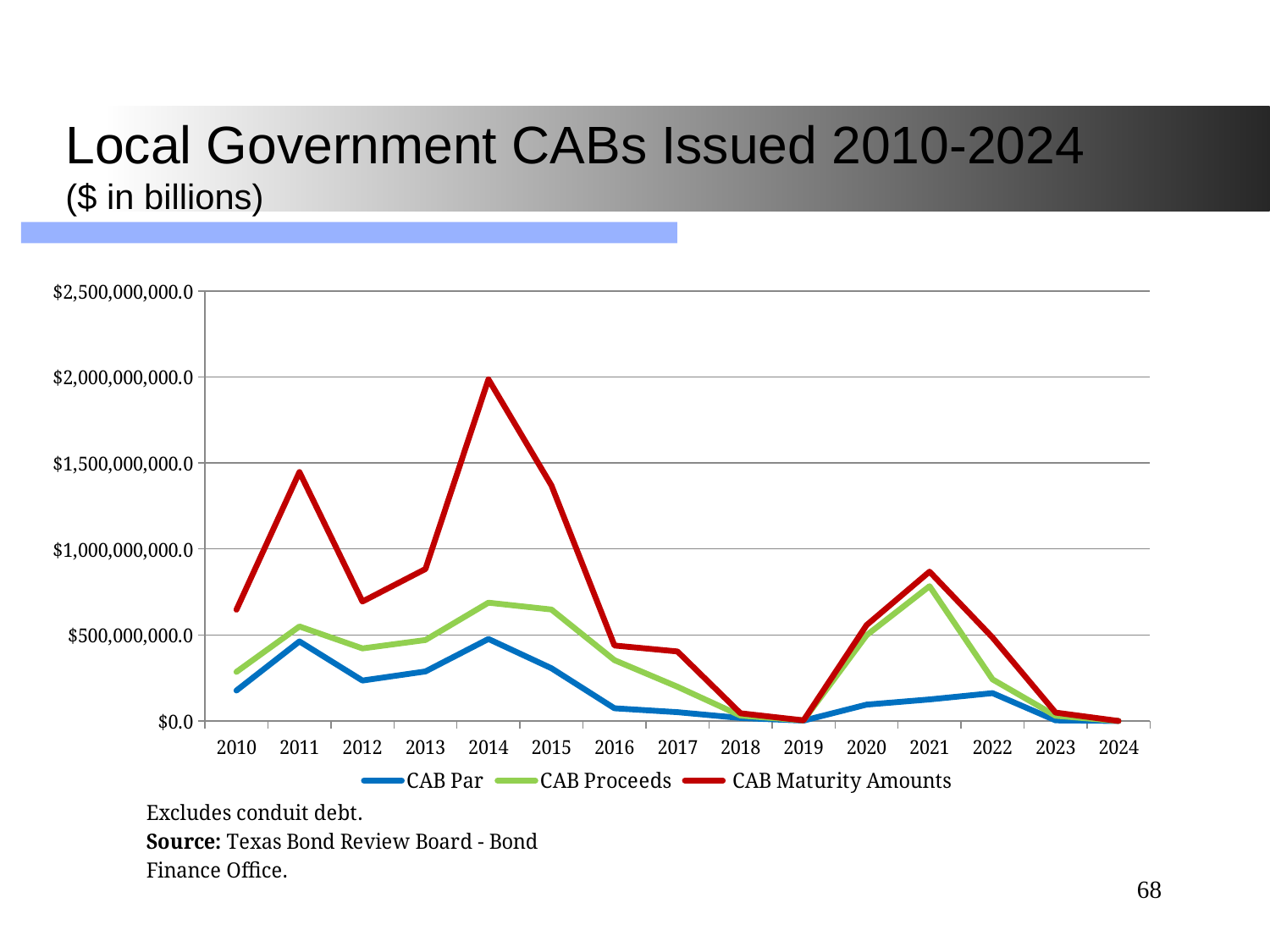
How many series does the legend list? 3 How many years are plotted along the x axis? 15 Is the value for CAB Maturity Amounts in 2012 greater or less than $1,000,000,000.0? less In which year does CAB Maturity Amounts reach its highest value? 2014 Which is larger for CAB Par: the value in 2016 or the value in 2022? 2022 What kind of chart is shown on the slide? line chart Which series has the lowest value in 2014? CAB Par Is the value for CAB Maturity Amounts in 2014 greater or less than $1,500,000,000.0? greater What colour is the CAB Maturity Amounts line? red Which is larger for CAB Maturity Amounts: the value in 2011 or the value in 2014? 2014 Do the CAB Maturity Amounts values rise or fall from 2014 to 2019? fall Is the value for CAB Proceeds in 2021 greater or less than $500,000,000.0? greater